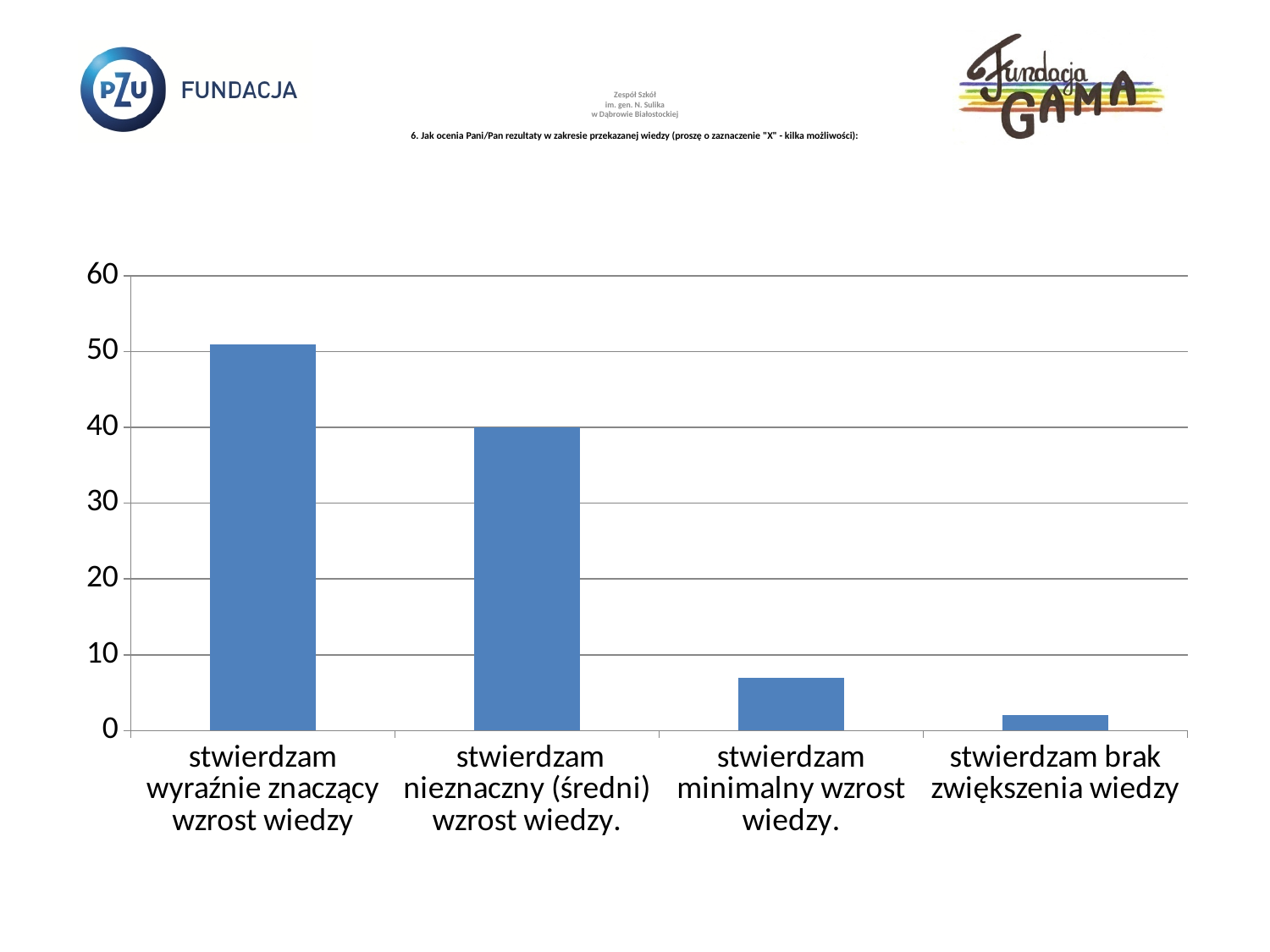
Is the value for 'stwierdzam brak zwiększenia wiedzy' greater or less than 10? less Which is larger: the value for 'stwierdzam nieznaczny (średni) wzrost wiedzy.' or the value for 'stwierdzam minimalny wzrost wiedzy.'? stwierdzam nieznaczny (średni) wzrost wiedzy. Do the bar values rise or fall from left to right along the x axis? fall What kind of chart is shown on the slide? bar chart Is the value for 'stwierdzam minimalny wzrost wiedzy.' greater or less than 10? less What is the highest value shown on the vertical axis of the chart? 60 How many categories are shown on the x axis of the chart? 4 What colour are the bars in the chart? blue Which category has the highest bar? stwierdzam wyraźnie znaczący wzrost wiedzy Is the value for 'stwierdzam wyraźnie znaczący wzrost wiedzy' greater or less than 60? less Which category has the lowest bar? stwierdzam brak zwiększenia wiedzy